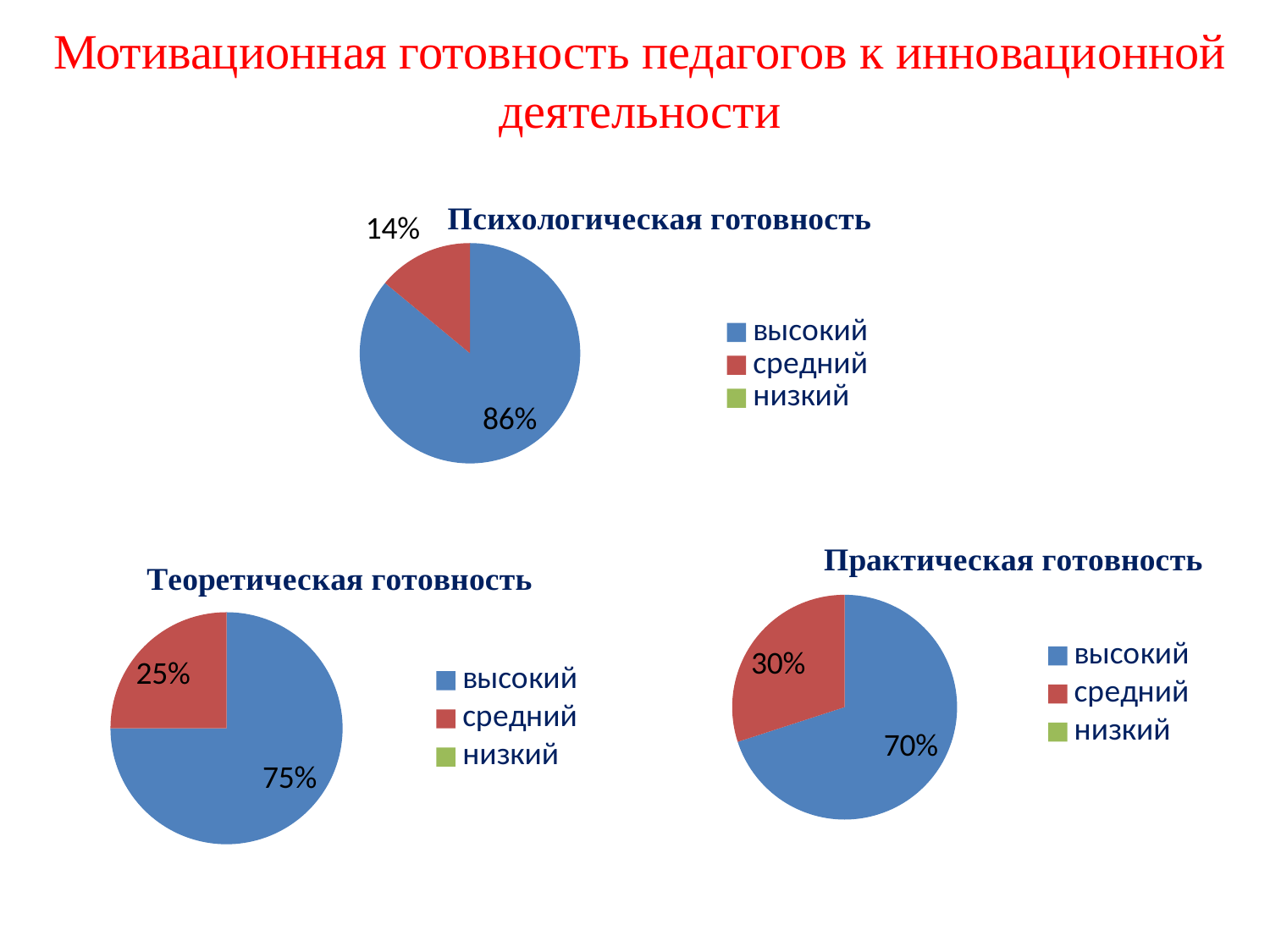
In the 'Психологическая готовность' chart, what is the value for 'высокий'? 86% In the 'Теоретическая готовность' chart, which category has the largest slice? высокий How many entries does the legend of the 'Практическая готовность' chart list? 3 What type of chart is 'Психологическая готовность'? pie chart Which is larger: 'высокий' in the 'Теоретическая готовность' chart or 'высокий' in the 'Практическая готовность' chart? Теоретическая готовность In the 'Теоретическая готовность' chart, what is the value for 'средний'? 25% In the 'Практическая готовность' chart, what is the difference between 'высокий' and 'средний'? 40% In the 'Психологическая готовность' chart, what is the difference between 'высокий' and 'средний'? 72% In the 'Практическая готовность' chart, what is the value for 'средний'? 30% In the 'Психологическая готовность' chart, what is the value for 'средний'? 14% In the 'Практическая готовность' chart, what is the value for 'высокий'? 70% How many pie charts are shown on the slide? 3